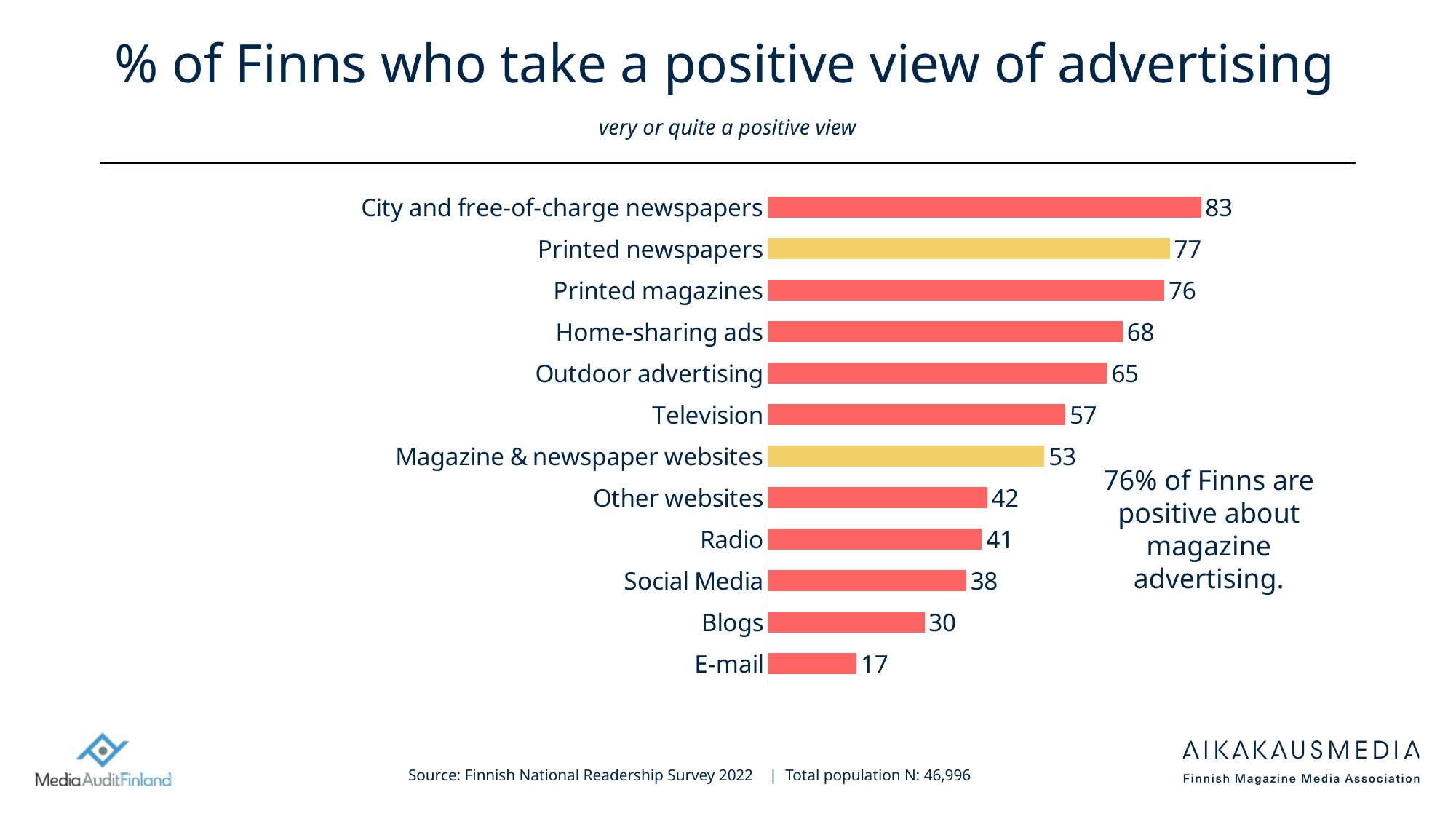
Which is larger, the value for Home-sharing ads or the value for Outdoor advertising? Home-sharing ads What is the title of the chart? % of Finns who take a positive view of advertising How many categories are shown in the chart? 12 Which category has the lowest value? E-mail What is the value for Blogs? 30 Which category has the highest value? City and free-of-charge newspapers What is the value for Television? 57 What is the difference between the values for Printed newspapers and Social Media? 39 Which two categories are highlighted with yellow bars? Printed newspapers and Magazine & newspaper websites What kind of chart is shown on the slide? Bar chart What is the value for Printed magazines? 76 What is the difference between the values for Magazine & newspaper websites and Other websites? 11